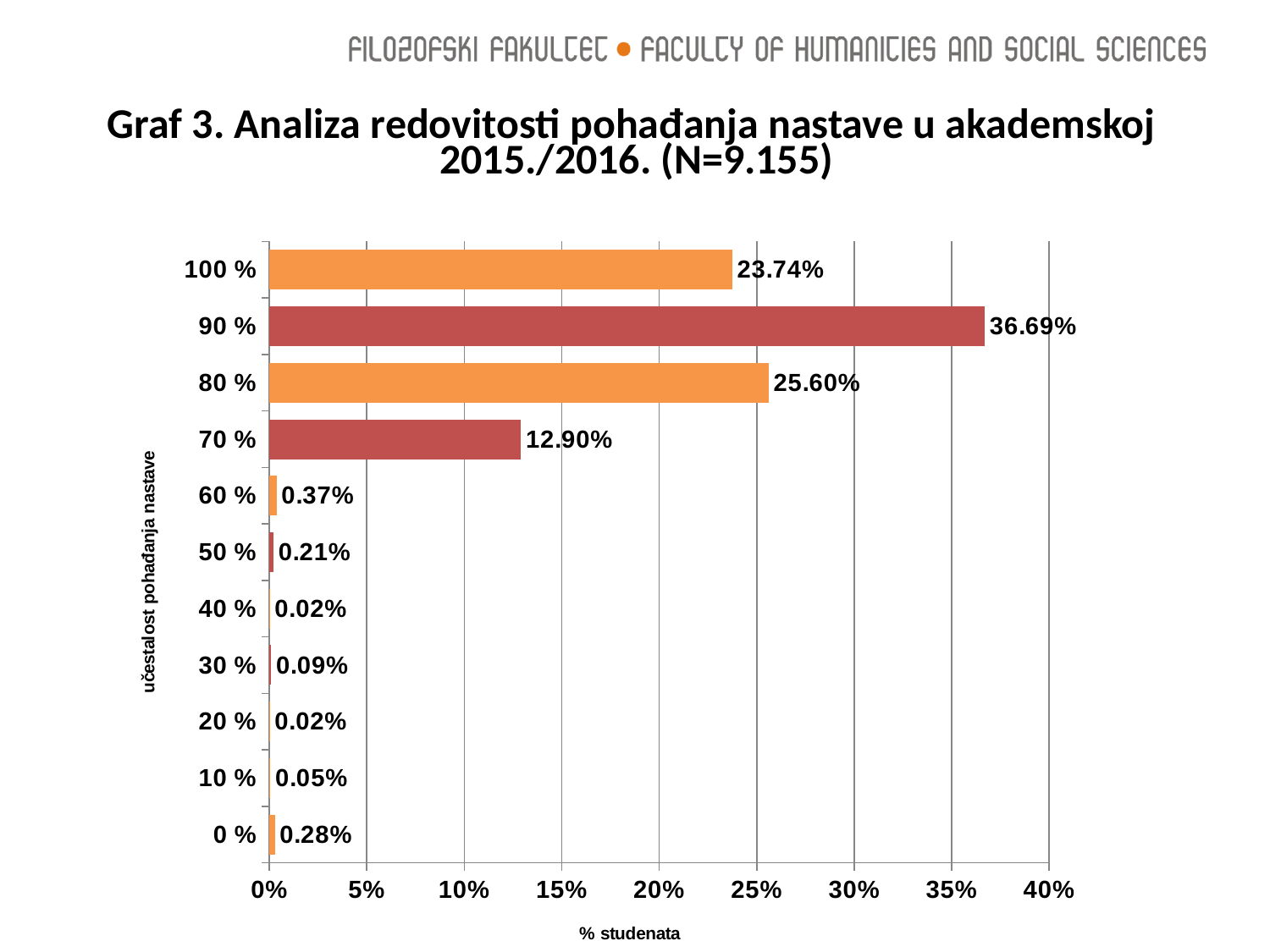
What kind of chart is shown on the slide? Bar chart What is the difference between the values for the 90 % and 80 % attendance categories? 11.09% What percentage of students is shown for the 90 % attendance category? 36.69% What is the value for the 0 % attendance category? 0.28% What is the value for the 100 % attendance category? 23.74% Is the value for the 90 % attendance category greater or less than 35%? greater Which has a larger value, the 80 % category or the 100 % category? 80 % How many attendance categories are shown on the chart? 11 Which attendance category has the highest percentage of students? 90 % What value is shown for the 70 % attendance category? 12.90% What is the difference between the values for the 100 % and 70 % attendance categories? 10.84% What is the title of the horizontal axis of the chart? % studenata